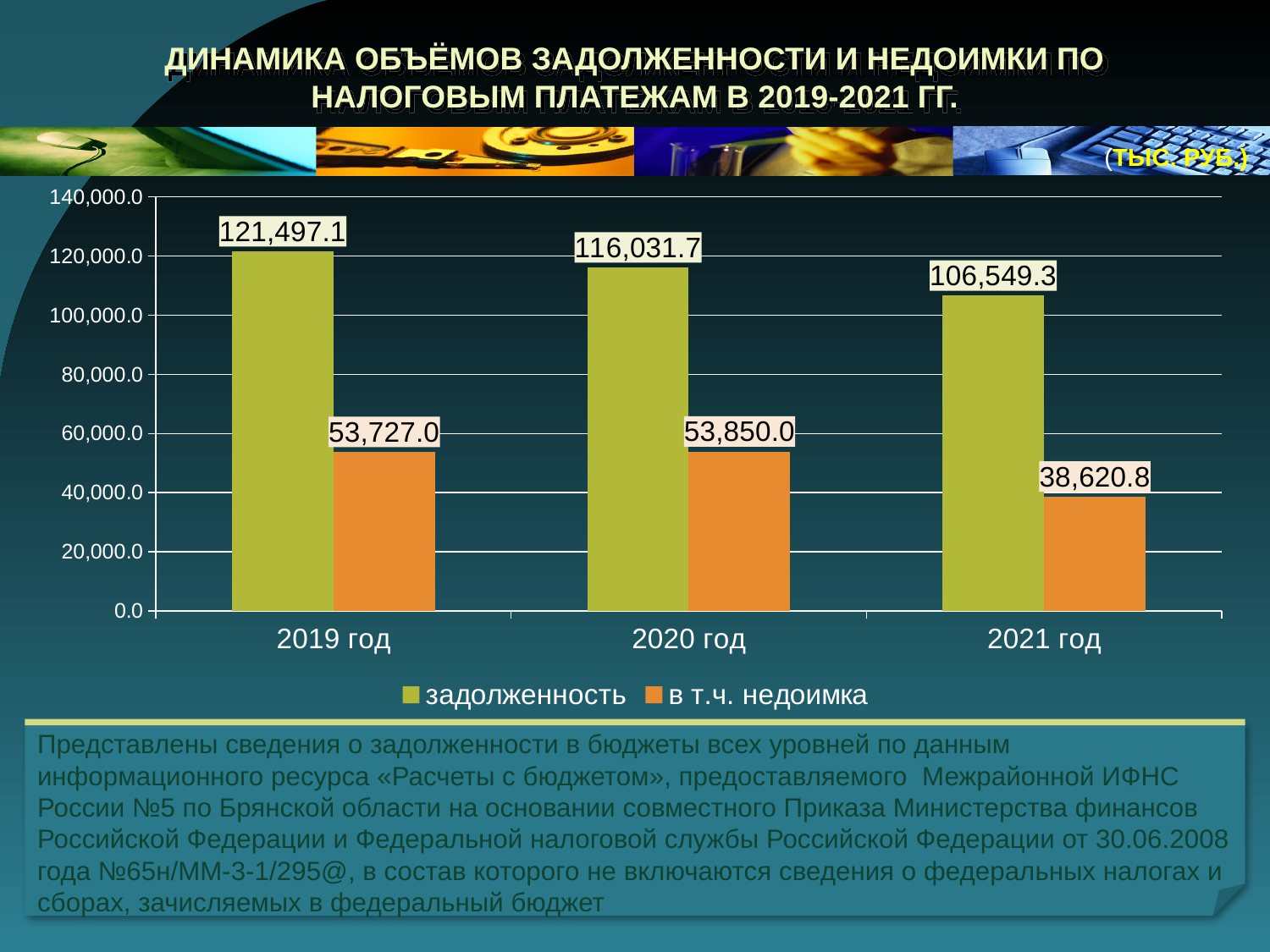
What is the difference between задолженность and в т.ч. недоимка in 2019 год? 67,770.1 How many series does the legend list? 2 What is the value of задолженность for 2019 год? 121,497.1 What is the value of в т.ч. недоимка for 2020 год? 53,850.0 What kind of chart is shown on the slide? Bar chart By how much did задолженность decrease from 2020 год to 2021 год? 9,482.4 Which is larger: задолженность in 2021 год or задолженность in 2019 год? задолженность in 2019 год In which year is в т.ч. недоимка the lowest? 2021 год Does задолженность rise or fall from 2019 год to 2021 год? Fall What is the value of в т.ч. недоимка for 2021 год? 38,620.8 What is the value of задолженность for 2020 год? 116,031.7 In which year is задолженность the highest? 2019 год